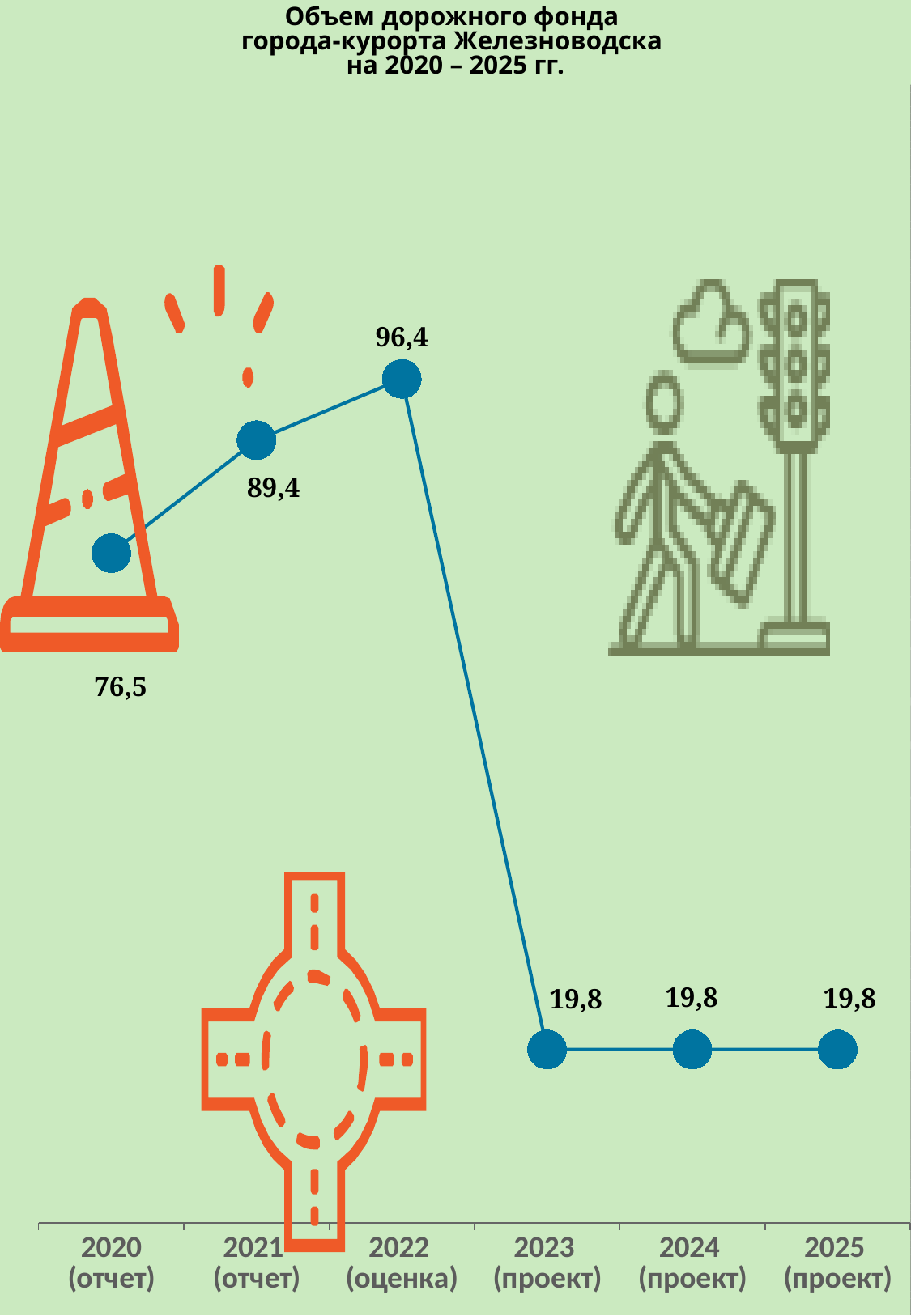
What is the lowest value plotted on the chart? 19,8 Do the values rise or fall from 2020 to 2022? rise What kind of chart is shown on the slide? line chart What is the value for 2020 (отчет)? 76,5 What is the value for 2022 (оценка)? 96,4 How many data points are plotted on the chart? 6 Which is larger, the value for 2020 (отчет) or the value for 2023 (проект)? 2020 (отчет) Which year has the highest value? 2022 (оценка) What is the value for 2024 (проект)? 19,8 What is the value for 2021 (отчет)? 89,4 What is the difference between the values for 2022 (оценка) and 2021 (отчет)? 7 What is the difference between the values for 2021 (отчет) and 2020 (отчет)? 12,9